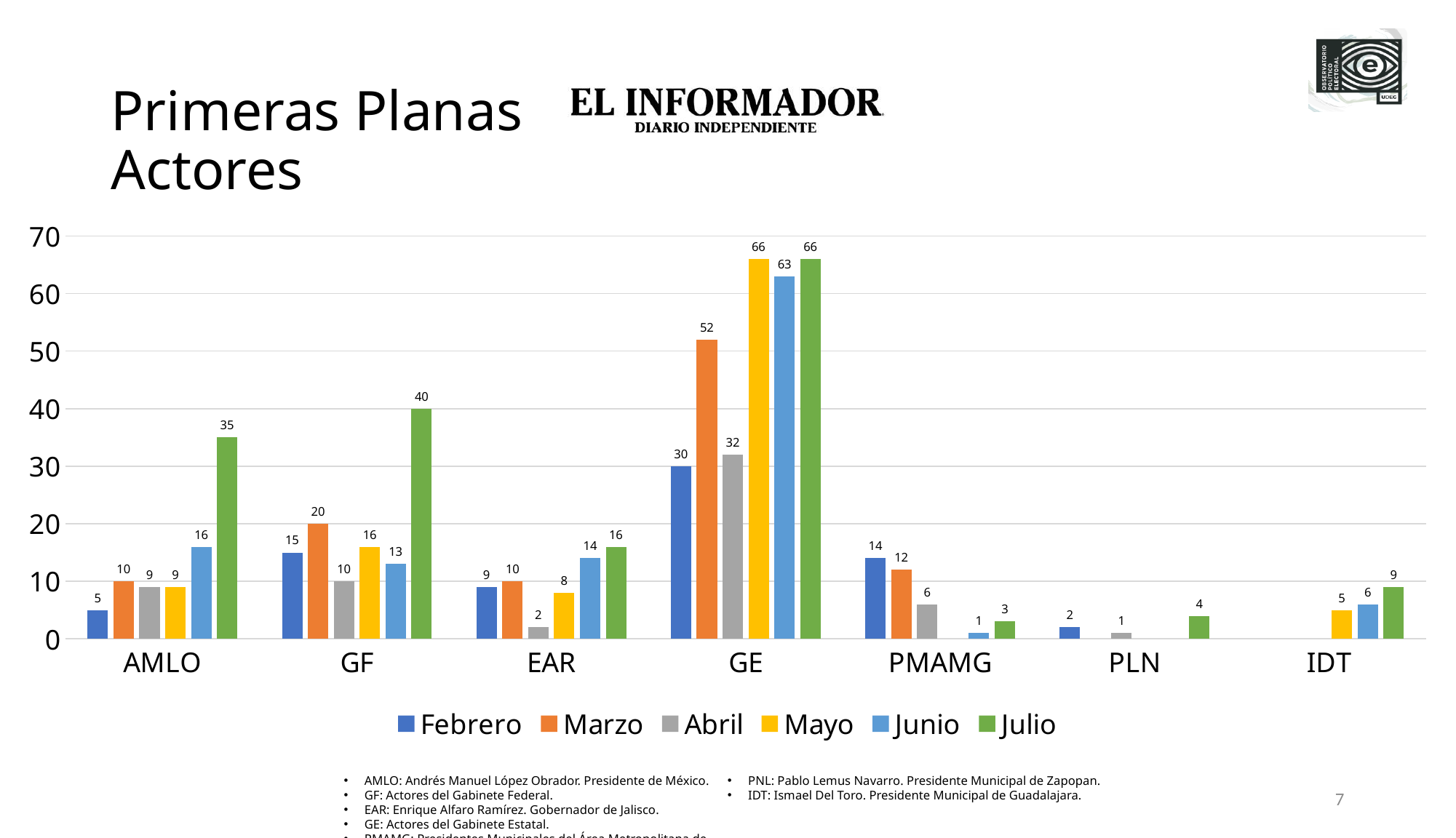
How many categories are shown on the x axis? 7 What is the difference between the Julio and Febrero values for GF? 25 What is the value for AMLO in Julio? 35 Which category has the lowest Febrero value among those with a labelled Febrero bar? PLN What is the value for EAR in Abril? 2 Which newspaper is named at the top of the slide? El Informador Which is larger for PMAMG: the Febrero value or the Marzo value? Febrero Which category has the highest Julio value? GE What is the value for GE in Marzo? 52 How many series does the legend list? 6 What kind of chart is shown on the slide? bar chart Is the Mayo value for GE greater or less than 60? greater